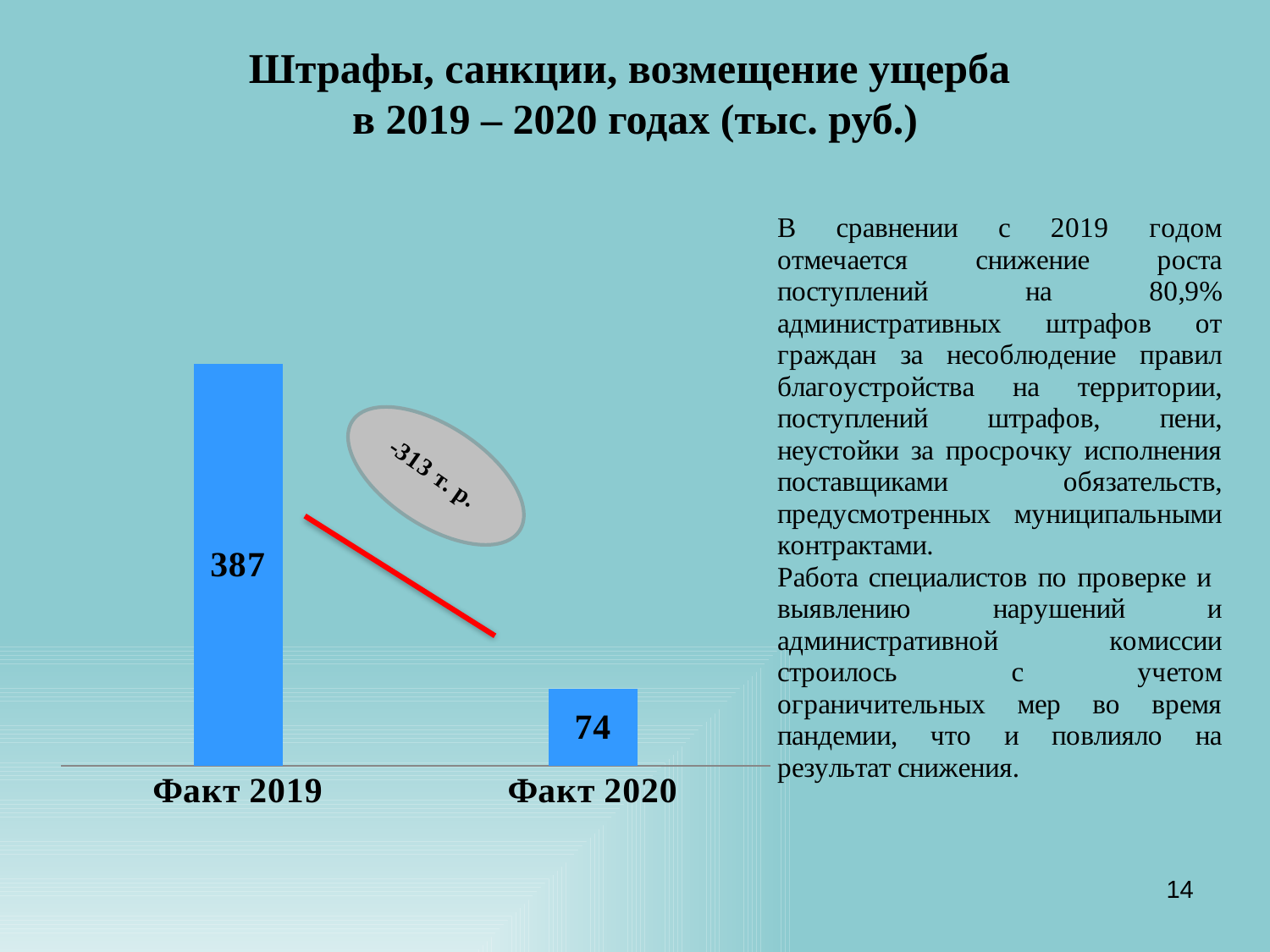
Which category has the lowest value? Факт 2020 What is the value for Факт 2020? 74 What is the value for Факт 2019? 387 How many categories are shown in the chart? 2 What change is written in the oval callout on the chart? -313 т. р. Do the values rise or fall from Факт 2019 to Факт 2020? fall What units are given in the slide title for the chart values? тыс. руб. Which is larger, the value for Факт 2019 or Факт 2020? Факт 2019 What is the difference between the values for Факт 2019 and Факт 2020? 313 What kind of chart is shown on the slide? bar chart Which category has the highest value? Факт 2019